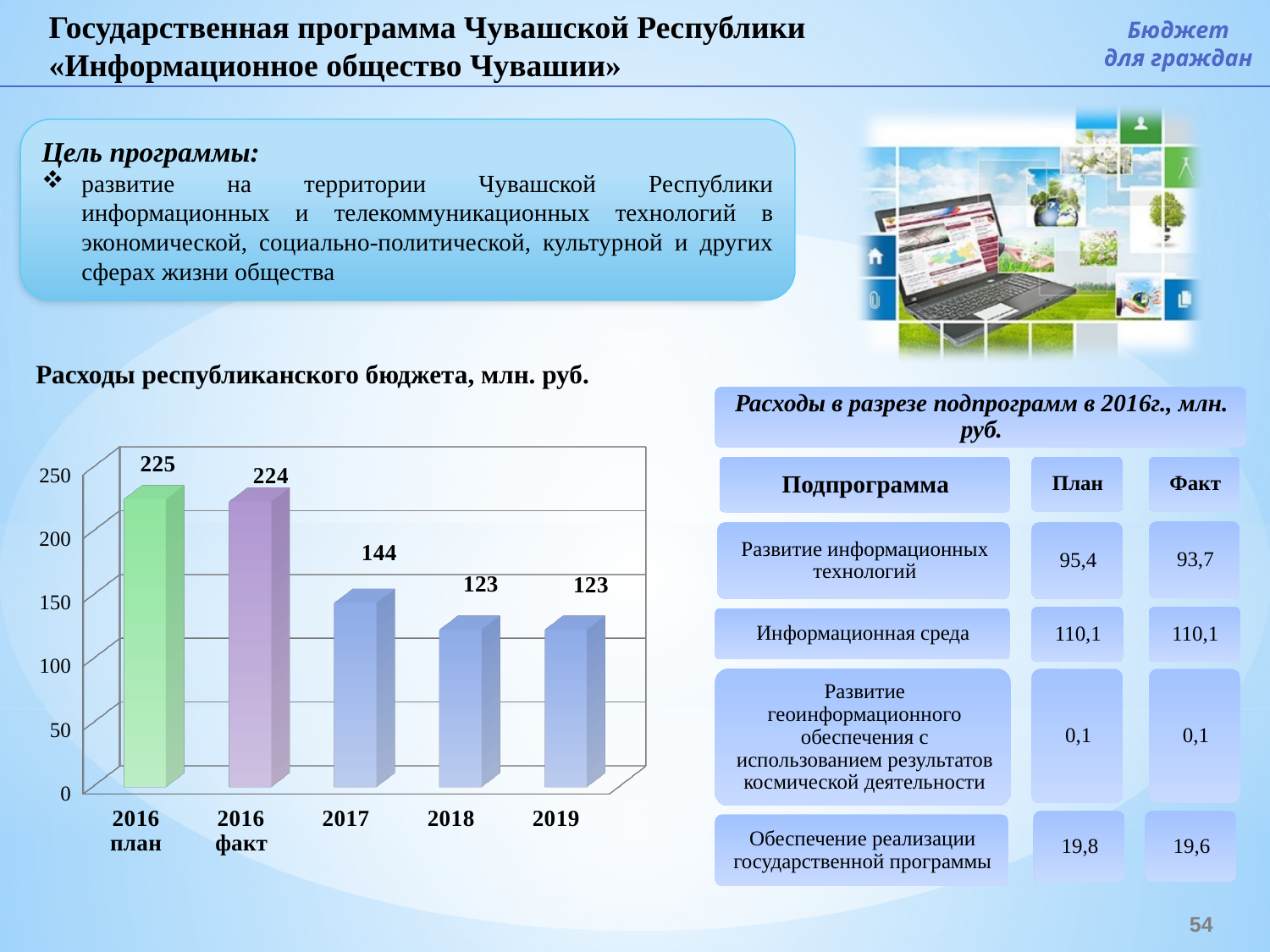
What kind of chart is shown on the slide? bar chart What is the value for 2017 in the chart "Расходы республиканского бюджета, млн. руб."? 144 What is the difference between the values for 2017 and 2018? 21 Do the values in the chart rise or fall from "2016 план" to 2019? fall Is the value for 2017 greater or less than 100? greater What is the difference between the values for "2016 план" and "2016 факт"? 1 What is the value for "2016 план" in the chart? 225 How many categories are shown on the x axis of the chart? 5 What is the value for "2016 факт" in the chart? 224 What is the value for 2019 in the chart? 123 Which category has the highest value in the chart? 2016 план Which is larger, the value for 2017 or the value for 2018? 2017